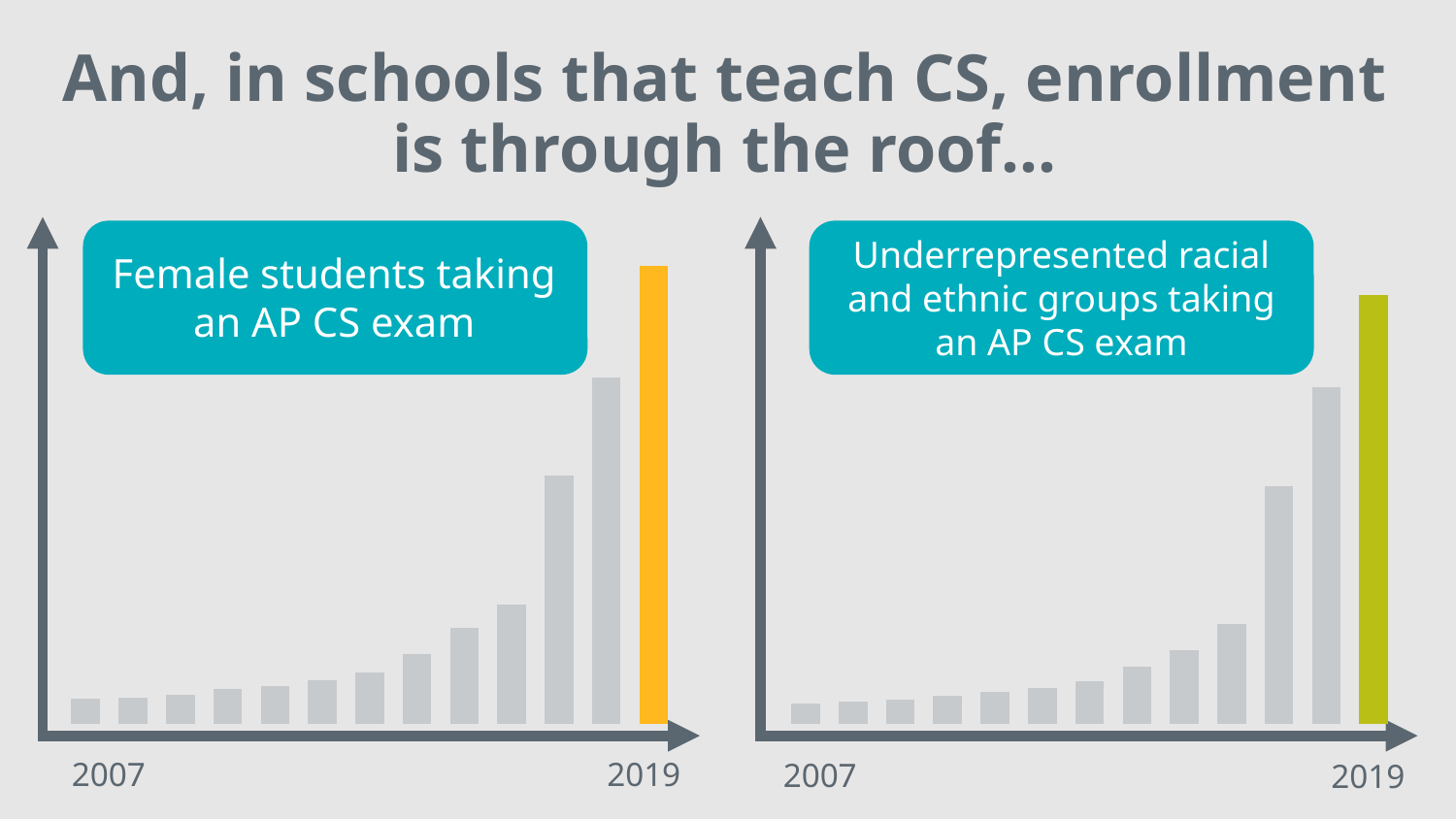
What colour is the 2019 bar in the right chart, 'Underrepresented racial and ethnic groups taking an AP CS exam'? yellow-green In the right chart, 'Underrepresented racial and ethnic groups taking an AP CS exam', which year has the highest bar? 2019 In the right chart, 'Underrepresented racial and ethnic groups taking an AP CS exam', do the values rise or fall from 2007 to 2019? rise How many bars are plotted in the right chart, 'Underrepresented racial and ethnic groups taking an AP CS exam'? 13 What kind of chart is the right chart, 'Underrepresented racial and ethnic groups taking an AP CS exam'? bar chart How many bars are plotted in the left chart, 'Female students taking an AP CS exam'? 13 In the right chart, 'Underrepresented racial and ethnic groups taking an AP CS exam', which is larger, the bar for 2007 or the bar for 2019? 2019 In the left chart, 'Female students taking an AP CS exam', which year has the highest bar? 2019 In the left chart, 'Female students taking an AP CS exam', do the values rise or fall from 2007 to 2019? rise What kind of chart is the left chart, 'Female students taking an AP CS exam'? bar chart In the left chart, 'Female students taking an AP CS exam', which is larger, the bar for 2007 or the bar for 2019? 2019 What is the first year labelled on the x axis of the left chart, 'Female students taking an AP CS exam'? 2007